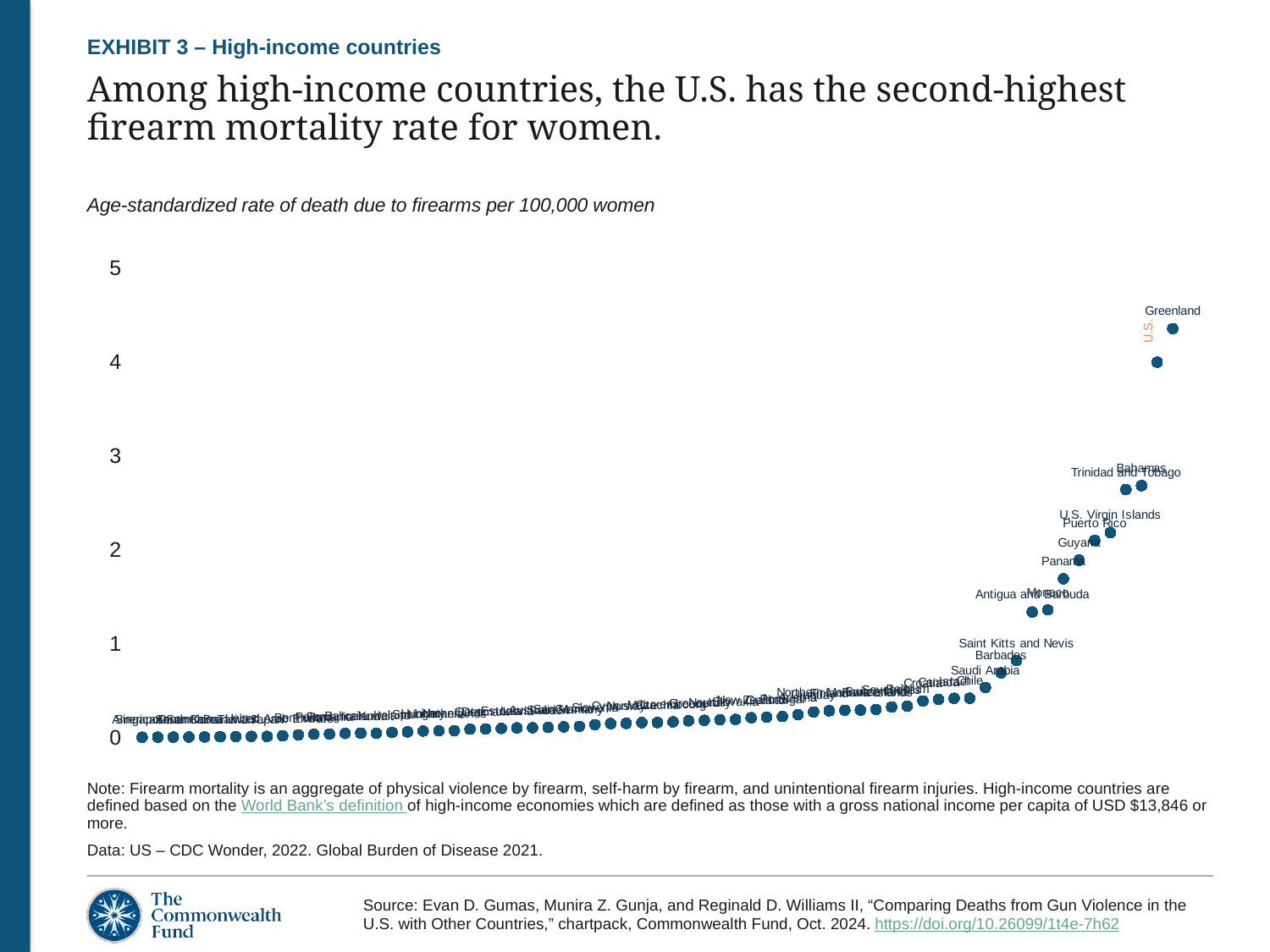
Which has a higher value, Greenland or the Bahamas? Greenland Is the value for the U.S. greater or less than 3? greater Do the plotted values rise or fall moving from left to right along the x axis? rise According to the slide, which country has the second-highest firearm mortality rate for women among high-income countries? U.S. Which country has the highest age-standardized firearm death rate for women on the chart? Greenland Is the value for Panama greater or less than 2? less Is the value for the Bahamas greater or less than 3? less Which has a higher value, Trinidad and Tobago or Panama? Trinidad and Tobago What kind of chart is shown on the slide? Scatter (dot) chart